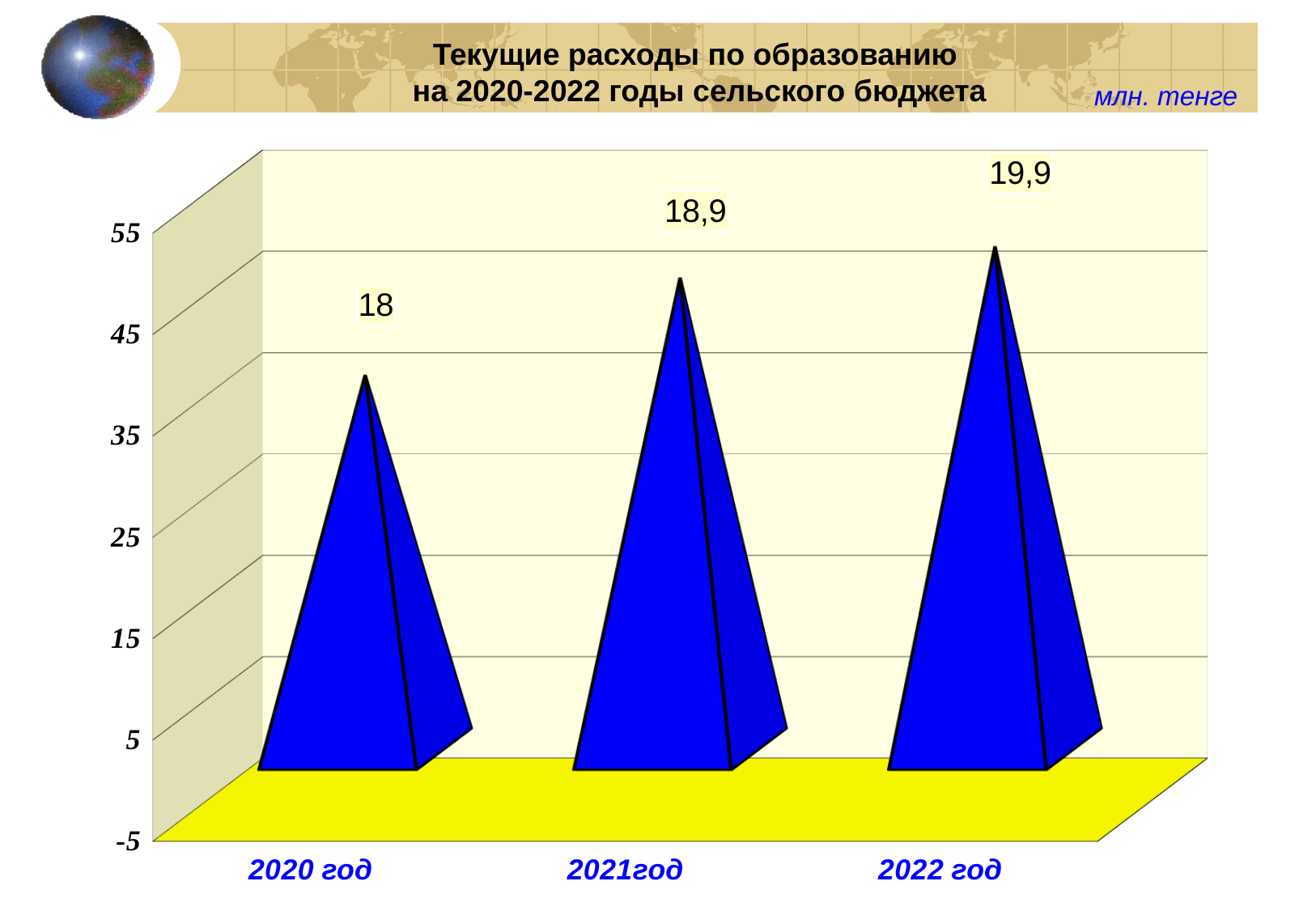
What unit is indicated for the values on the chart? млн. тенге What is the difference between the values for 2021год and 2020 год? 0,9 Which year has the highest value? 2022 год What is the value for 2022 год? 19,9 Do the values rise or fall from 2020 год to 2022 год? rise What is the value for 2020 год? 18 Which is larger, the value for 2021год or the value for 2022 год? 2022 год What is the difference between the values for 2022 год and 2020 год? 1,9 Which year has the lowest value? 2020 год What is the value for 2021год? 18,9 How many years are shown on the chart? 3 What kind of chart is this? bar chart